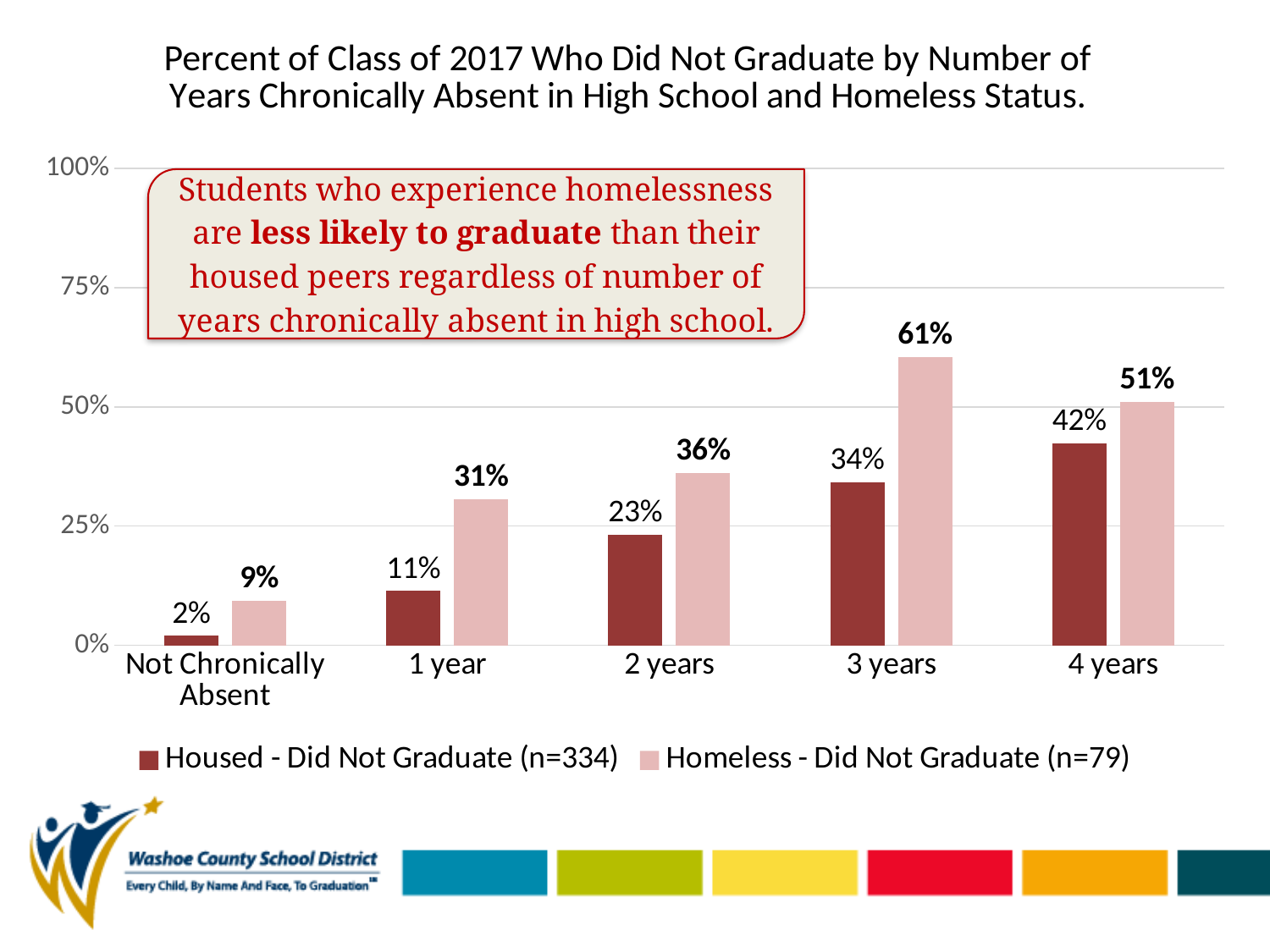
What is the value for Housed - Did Not Graduate at 1 year? 11% Which is larger at 4 years: Housed - Did Not Graduate or Homeless - Did Not Graduate? Homeless - Did Not Graduate Which category has the highest value for Homeless - Did Not Graduate? 3 years What is the value for Housed - Did Not Graduate for Not Chronically Absent? 2% What is the difference between the Homeless and Housed values at 3 years? 27% How many series does the legend list? 2 Is the value for Homeless - Did Not Graduate at 2 years greater or less than 25%? greater What is the value for Homeless - Did Not Graduate at 3 years? 61% What kind of chart is shown on the slide? bar chart Which category has the lowest value for Housed - Did Not Graduate? Not Chronically Absent What is the sample size (n) for the Homeless - Did Not Graduate series in the legend? 79 How many categories are shown on the x axis? 5